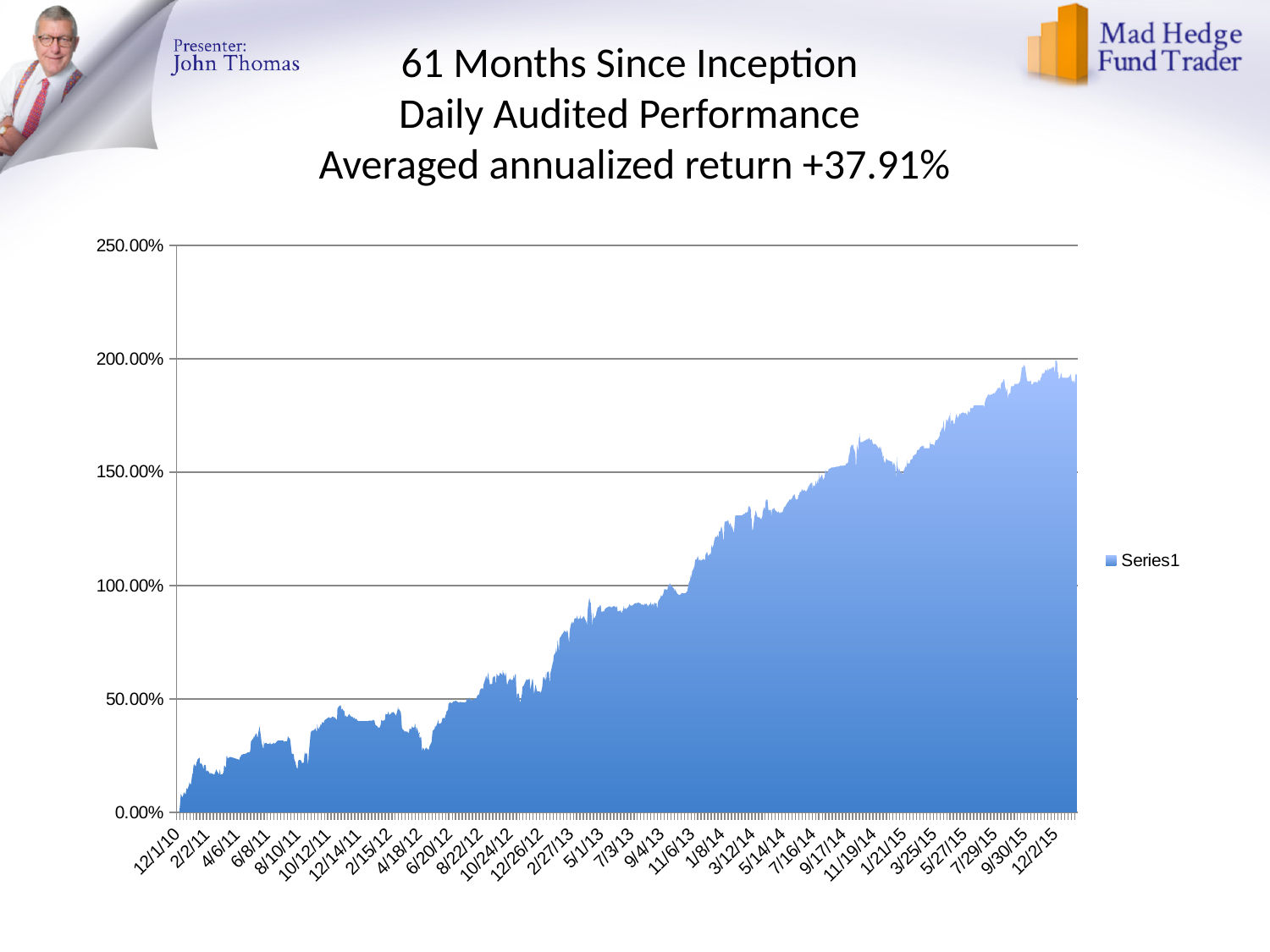
Is the value for 2/2/11 greater or less than 50.00%? less Which is larger, the value for 9/30/15 or the value for 6/8/11? 9/30/15 How many series does the legend list? 1 What is the name of the series shown in the legend? Series1 What averaged annualized return is stated in the chart title? +37.91% Is the value for 3/12/14 greater or less than 100.00%? greater What kind of chart is shown on the slide? area chart Is the value for 5/27/15 greater or less than 150.00%? greater Do the values generally rise or fall from 12/1/10 to 12/2/15? rise